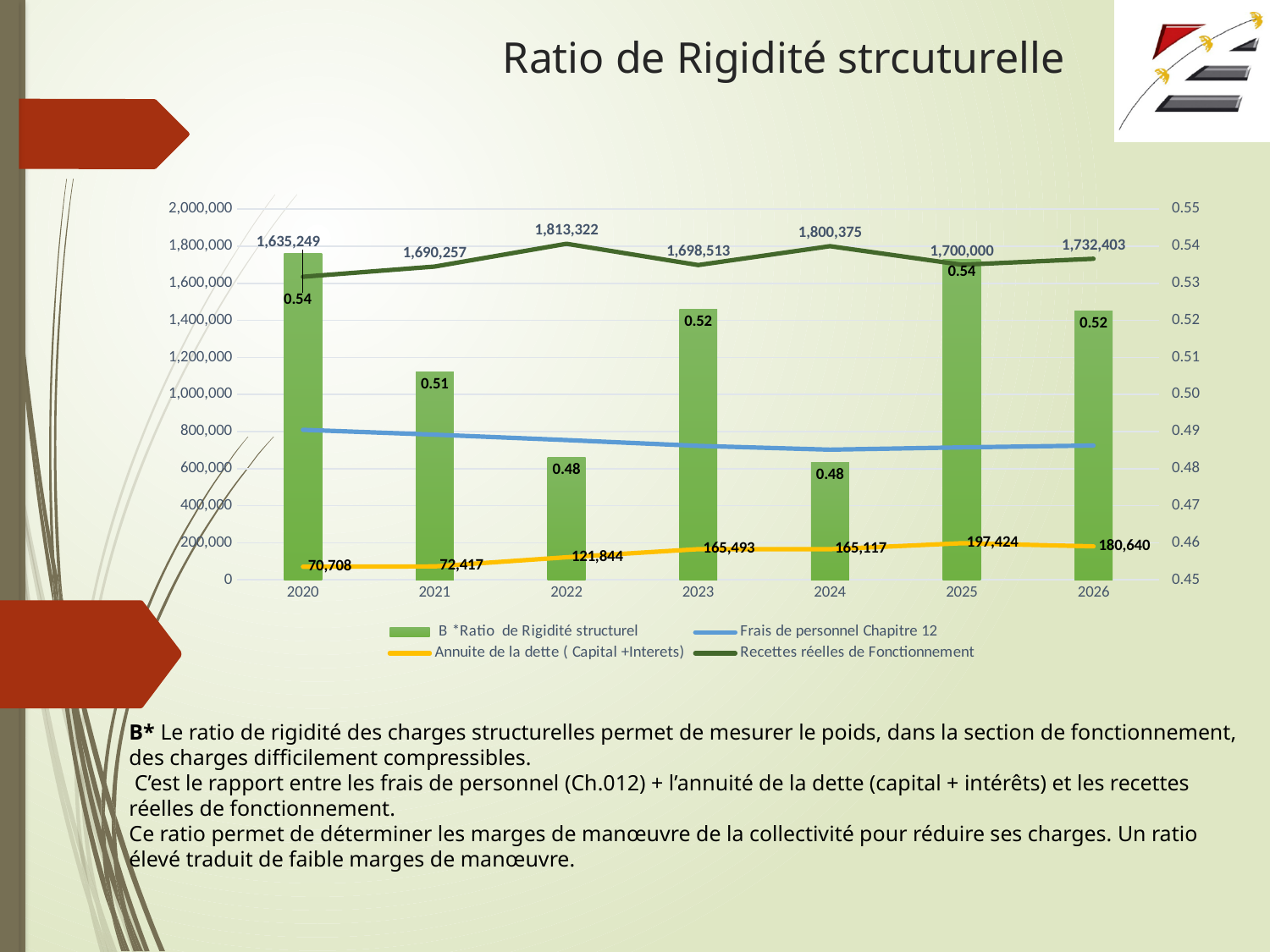
Is the Frais de personnel Chapitre 12 value for 2020 greater or less than 1,000,000? less What is the value of Recettes réelles de Fonctionnement in 2022? 1,813,322 How many years are shown on the x axis? 7 Does the Annuite de la dette (Capital + Interets) line generally rise or fall from 2020 to 2026? rise What is the B *Ratio de Rigidité structurel value for 2021? 0.51 In which year is Annuite de la dette (Capital + Interets) lowest? 2020 What is the difference between the Annuite de la dette values for 2026 and 2020? 109,932 Which is larger, Recettes réelles de Fonctionnement in 2024 or in 2023? 2024 In which year is Recettes réelles de Fonctionnement highest? 2022 What is the title of the slide containing the chart? Ratio de Rigidité strcuturelle What is the Annuite de la dette (Capital + Interets) value for 2025? 197,424 How many series does the legend list? 4